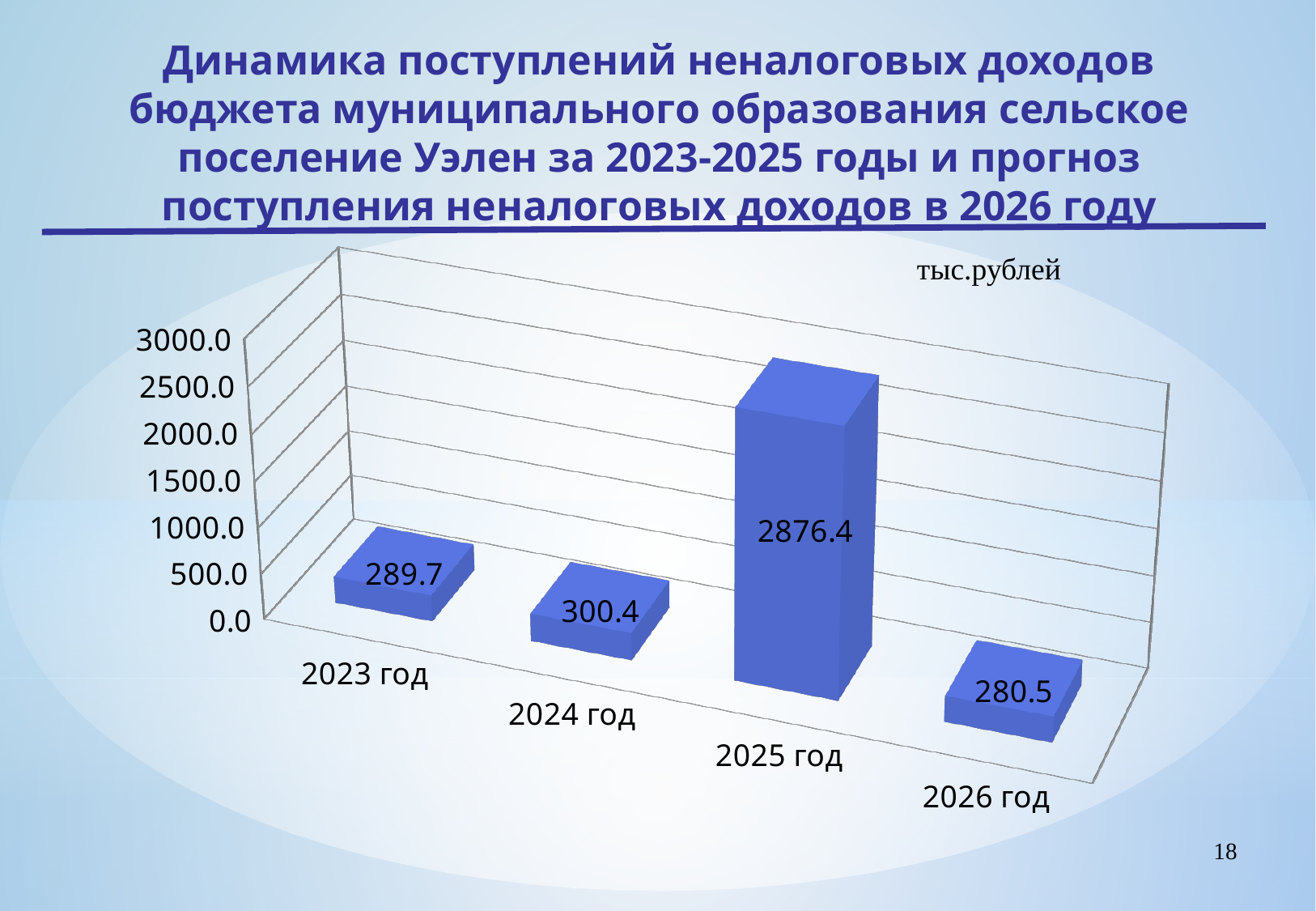
In what units are the values on the chart expressed? тыс.рублей What is the difference between the values for 2025 год and 2024 год? 2576.0 Which year has the highest value? 2025 год What is the difference between the values for 2024 год and 2023 год? 10.7 Which is larger, the value for 2023 год or 2024 год? 2024 год What is the value for 2023 год? 289.7 What is the value for 2025 год? 2876.4 How many years are shown on the chart? 4 What kind of chart is shown on the slide? bar chart Is the value for 2025 год greater or less than 2500.0? greater What is the forecast value for 2026 год? 280.5 Which year has the lowest value? 2026 год